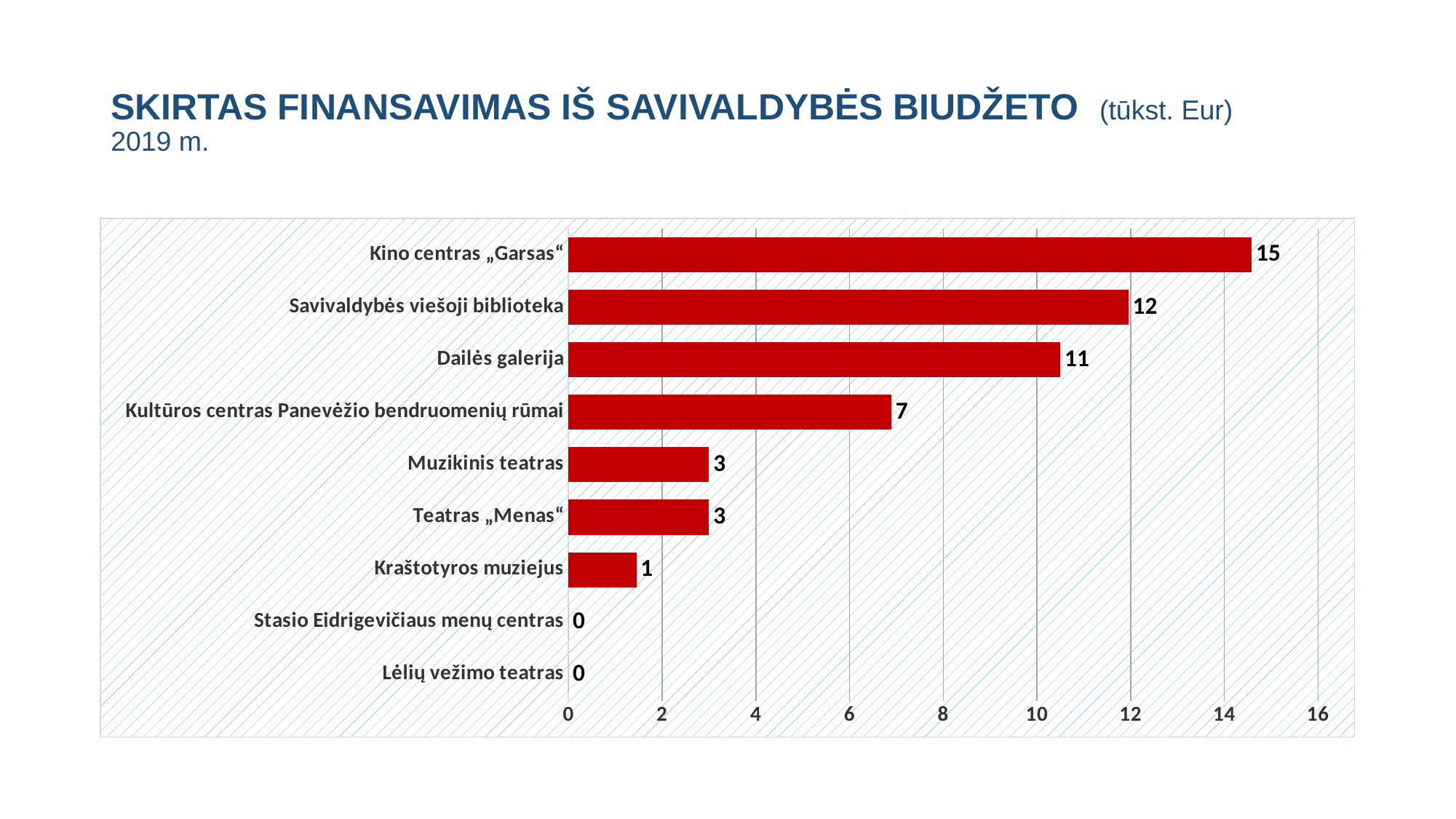
What is the difference between the values for Kino centras „Garsas“ and Dailės galerija? 4 Which is larger, the value for Dailės galerija or the value for Muzikinis teatras? Dailės galerija What value is shown for Savivaldybės viešoji biblioteka? 12 How many categories are shown in the chart? 9 Which category has the highest value? Kino centras „Garsas“ Is the value for Savivaldybės viešoji biblioteka greater or less than 10? greater What value is shown for Kino centras „Garsas“? 15 What value is shown for Kraštotyros muziejus? 1 What value is shown for Kultūros centras Panevėžio bendruomenių rūmai? 7 What unit is given in the chart title? tūkst. Eur What is the difference between the values for Savivaldybės viešoji biblioteka and Kultūros centras Panevėžio bendruomenių rūmai? 5 What kind of chart is shown on the slide? bar chart